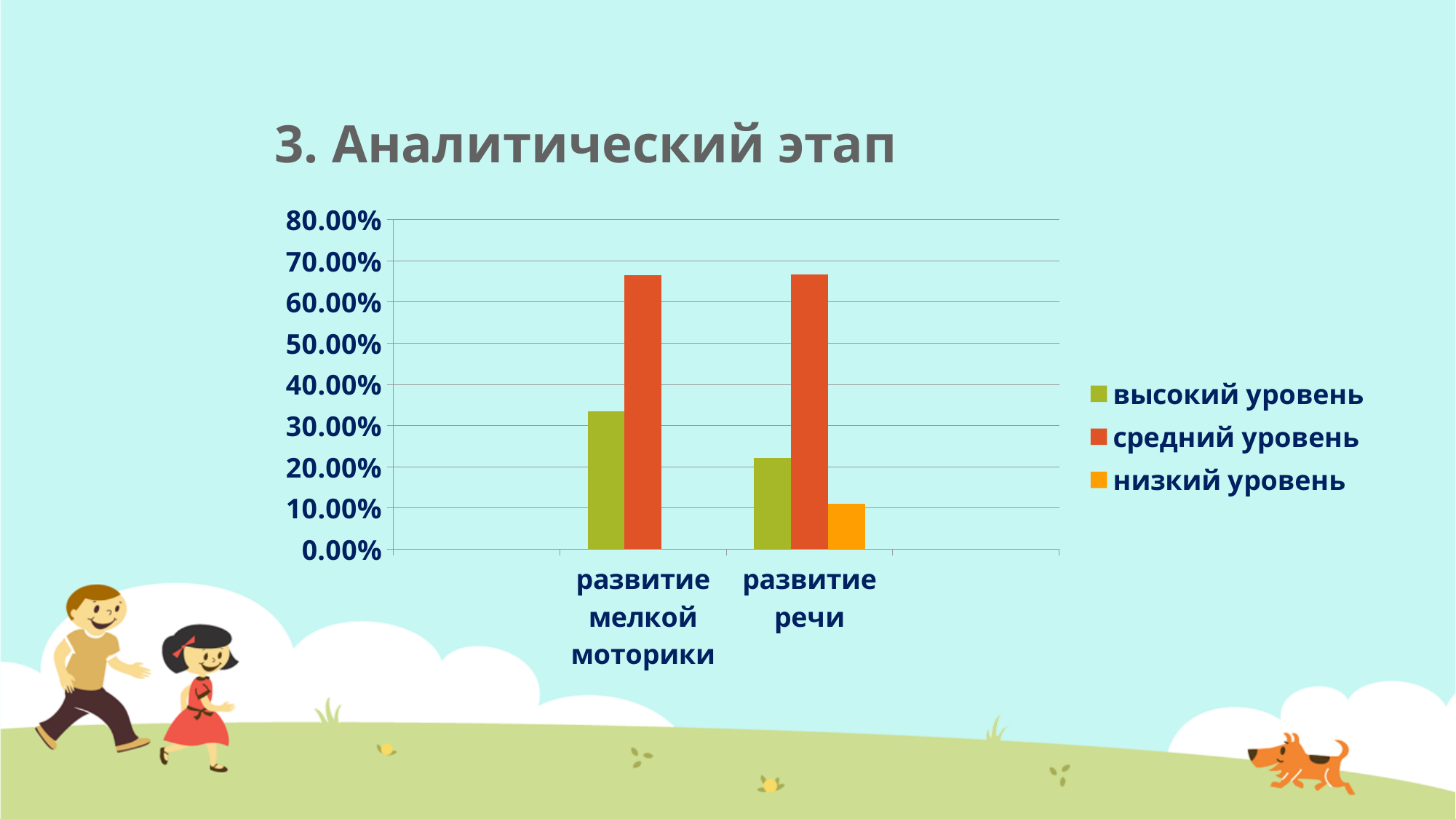
Which series is shown in orange-red in the legend? средний уровень What is the title of the slide above the chart? 3. Аналитический этап For высокий уровень, which category has the larger value: развитие мелкой моторики or развитие речи? развитие мелкой моторики How many series does the legend list? 3 Is the value for средний уровень in развитие мелкой моторики greater or less than 60%? greater Is the value for высокий уровень in развитие мелкой моторики greater or less than 40%? less Is the value for высокий уровень in развитие речи greater or less than 30%? less For развитие мелкой моторики, which is larger: высокий уровень or средний уровень? средний уровень What kind of chart is shown on the slide? bar chart How many categories are shown on the x axis? 2